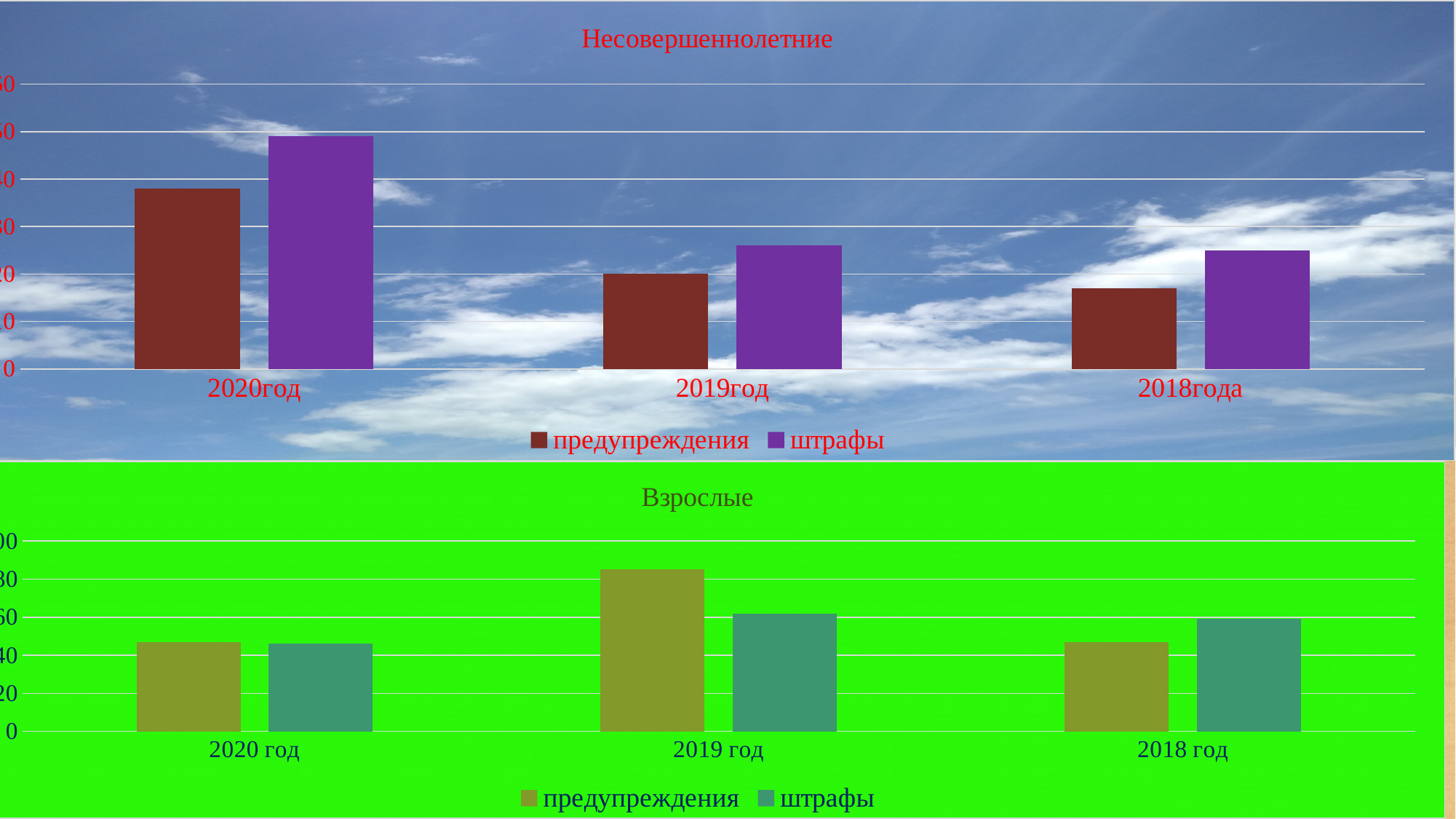
What are the two series named in the legend of the top chart "Несовершеннолетние"? предупреждения and штрафы In the bottom chart "Взрослые", how many series does the legend list? 2 In the top chart "Несовершеннолетние", which is larger for 2019год: предупреждения or штрафы? штрафы In the bottom chart "Взрослые", is the value for штрафы in 2020 год greater or less than 60? less What kind of chart is the top chart titled "Несовершеннолетние"? bar chart In the bottom chart "Взрослые", which is larger for 2018 год: предупреждения or штрафы? штрафы In the bottom chart "Взрослые", is the value for предупреждения in 2019 год greater or less than 80? greater What kind of chart is the bottom chart titled "Взрослые"? bar chart In the top chart "Несовершеннолетние", which year has the lowest value for предупреждения? 2018года In the bottom chart "Взрослые", which year has the highest value for предупреждения? 2019 год In the top chart "Несовершеннолетние", which year has the highest value for штрафы? 2020год In the top chart "Несовершеннолетние", how many year categories are shown on the x axis? 3